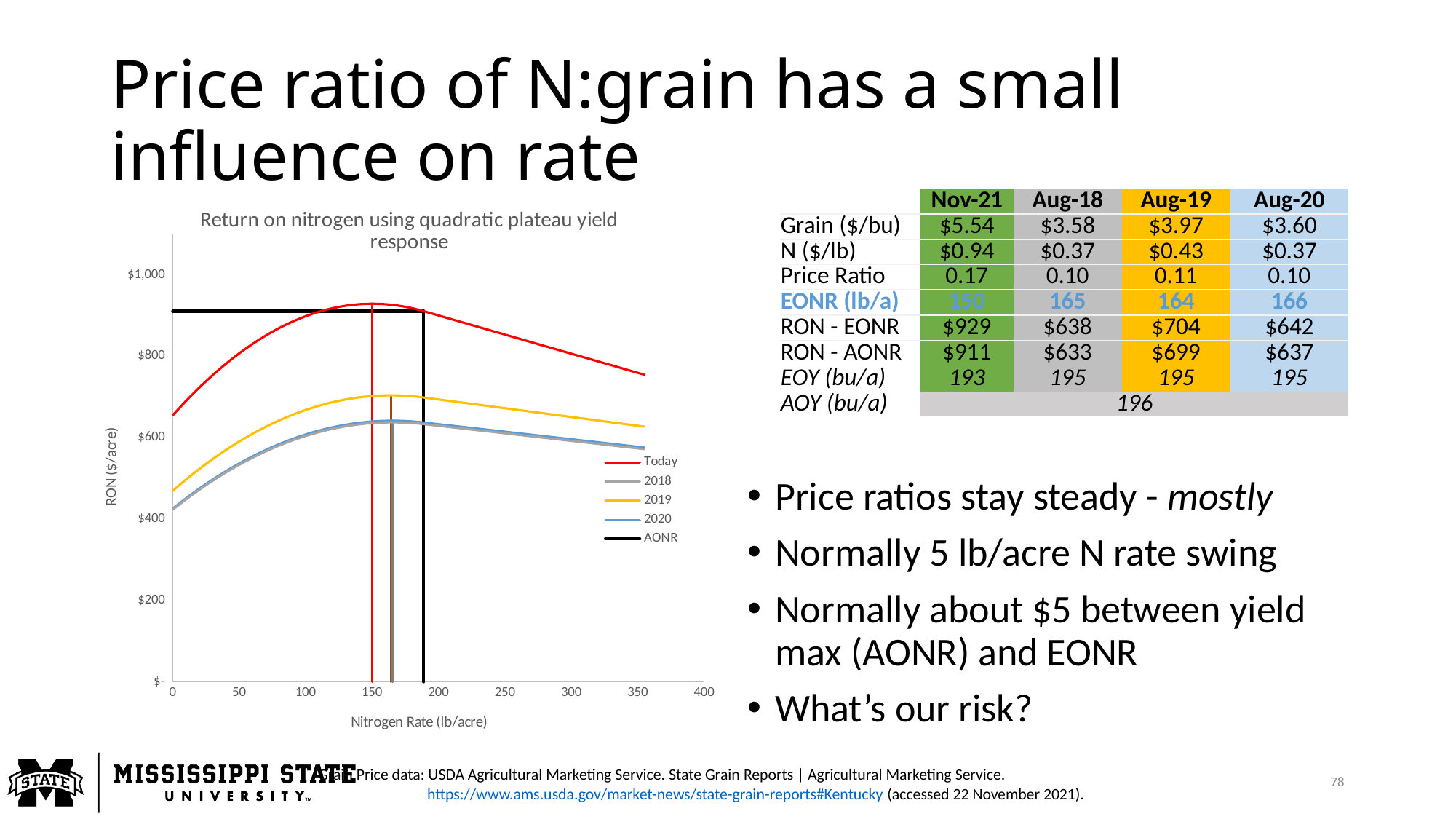
At a nitrogen rate of 150 lb/acre, which line is higher: Today or 2019? Today Which series reaches the highest RON value on the chart? Today What is the title of the chart? Return on nitrogen using quadratic plateau yield response Is the peak value of the 2019 line greater or less than $800? less Does the Today line rise or fall between a nitrogen rate of 200 and 350 lb/acre? fall Is the peak value of the Today line greater or less than $800? greater What is the label of the x axis of the chart? Nitrogen Rate (lb/acre) Is the value of the Today line at a nitrogen rate of 0 greater or less than $600? greater What kind of chart is shown on the slide? line chart Does the 2019 line rise or fall between a nitrogen rate of 0 and 100 lb/acre? rise How many series does the chart legend list? 5